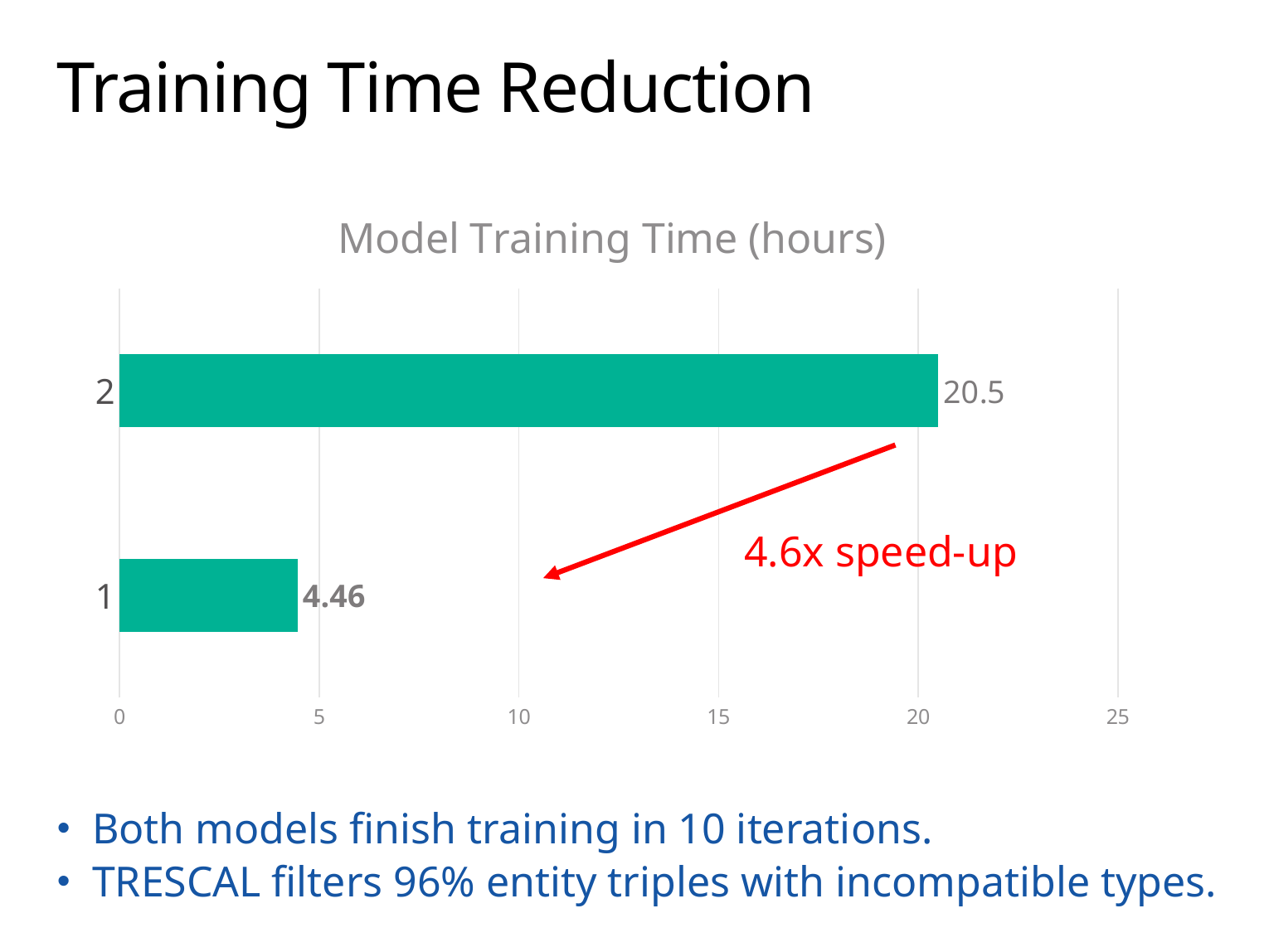
Which category has the highest training time? 2 What kind of chart is shown on the slide? bar chart What is the difference between the training times of category 2 and category 1? 16.04 Is the value for category 1 greater or less than 5? less What is the title of the chart? Model Training Time (hours) How many bars are plotted in the chart? 2 What speed-up is annotated in red on the chart? 4.6x speed-up Is the value for category 2 greater or less than 20? greater What is the value for category 2 in the Model Training Time (hours) chart? 20.5 What is the value for category 1 in the Model Training Time (hours) chart? 4.46 Which category has the lowest training time? 1 Which has a larger training time, category 1 or category 2? 2